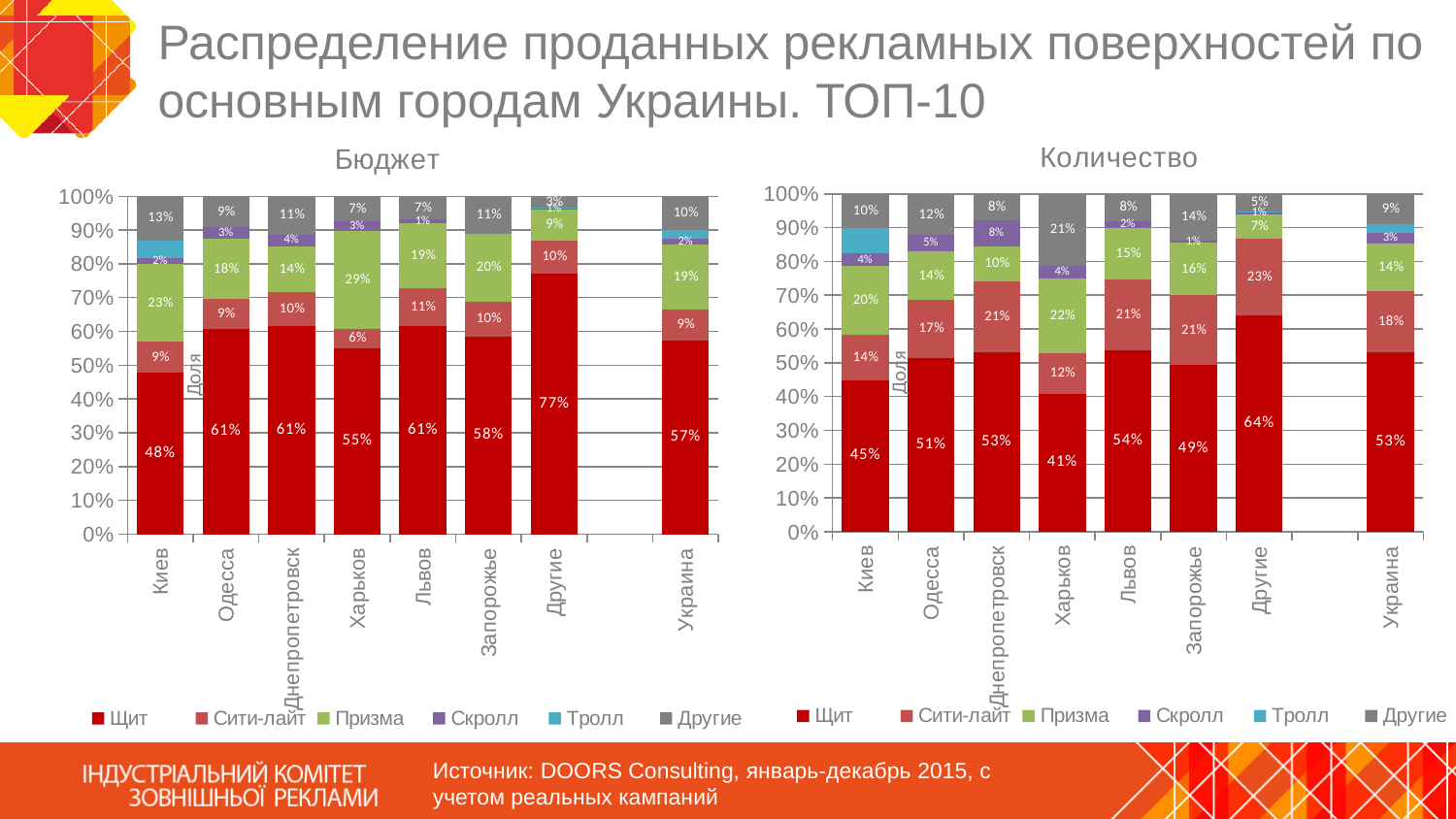
In the Количество chart, which category has the lowest Щит share? Харьков In the Количество chart, what is the Сити-лайт value for Украина? 18% How many categories are shown on the x axis of the Количество chart? 8 In the Бюджет chart, which category has the highest Щит share? Другие In the Бюджет chart, what is the value of Щит for Киев? 48% In the Бюджет chart, what is the Призма value for Харьков? 29% In the Количество chart, which is larger: the Щит value for Львов or for Запорожье? Львов In the Количество chart, what is the value of Щит for Харьков? 41% What type of chart is the Бюджет chart? Stacked bar chart In the Количество chart, what is the Другие series value for Харьков? 21% In the Бюджет chart, what is the difference between the Щит values for Другие and Киев? 29% How many series does the legend of the Бюджет chart list? 6